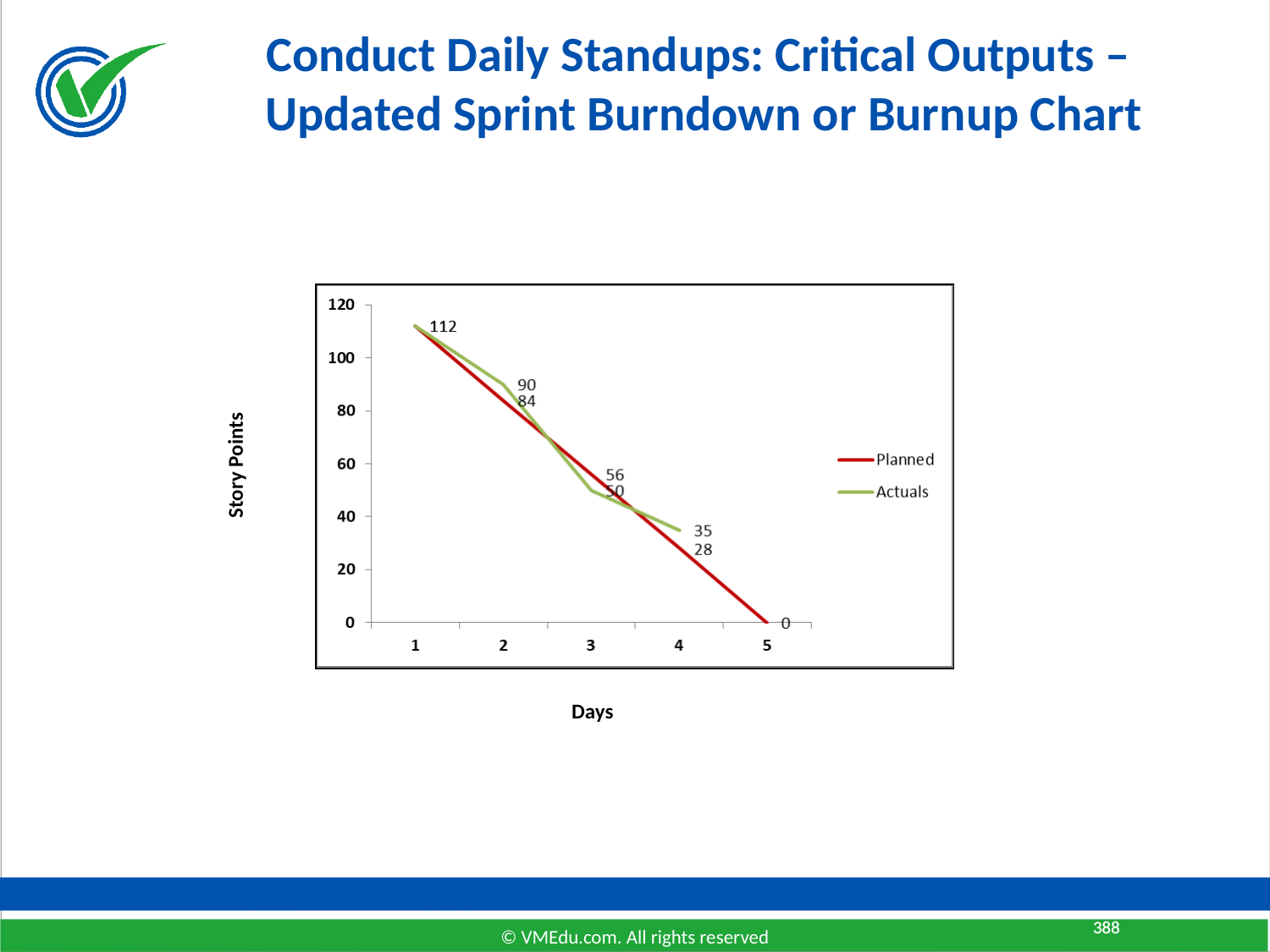
Do the Planned story points rise or fall from day 1 to day 5? fall What is the label on the vertical axis? Story Points What is the Planned value of story points on day 2? 84 How many series does the legend list? 2 What is the Planned value of story points on day 5? 0 What are the two series named in the legend? Planned and Actuals What is the Actuals value of story points on day 2? 90 What is the difference between the Actuals and Planned values on day 4? 7 What is the Actuals value of story points on day 4? 35 What type of chart is shown on the slide? line chart What is the Planned value of story points on day 1? 112 On day 3, which series has the higher value, Planned or Actuals? Planned